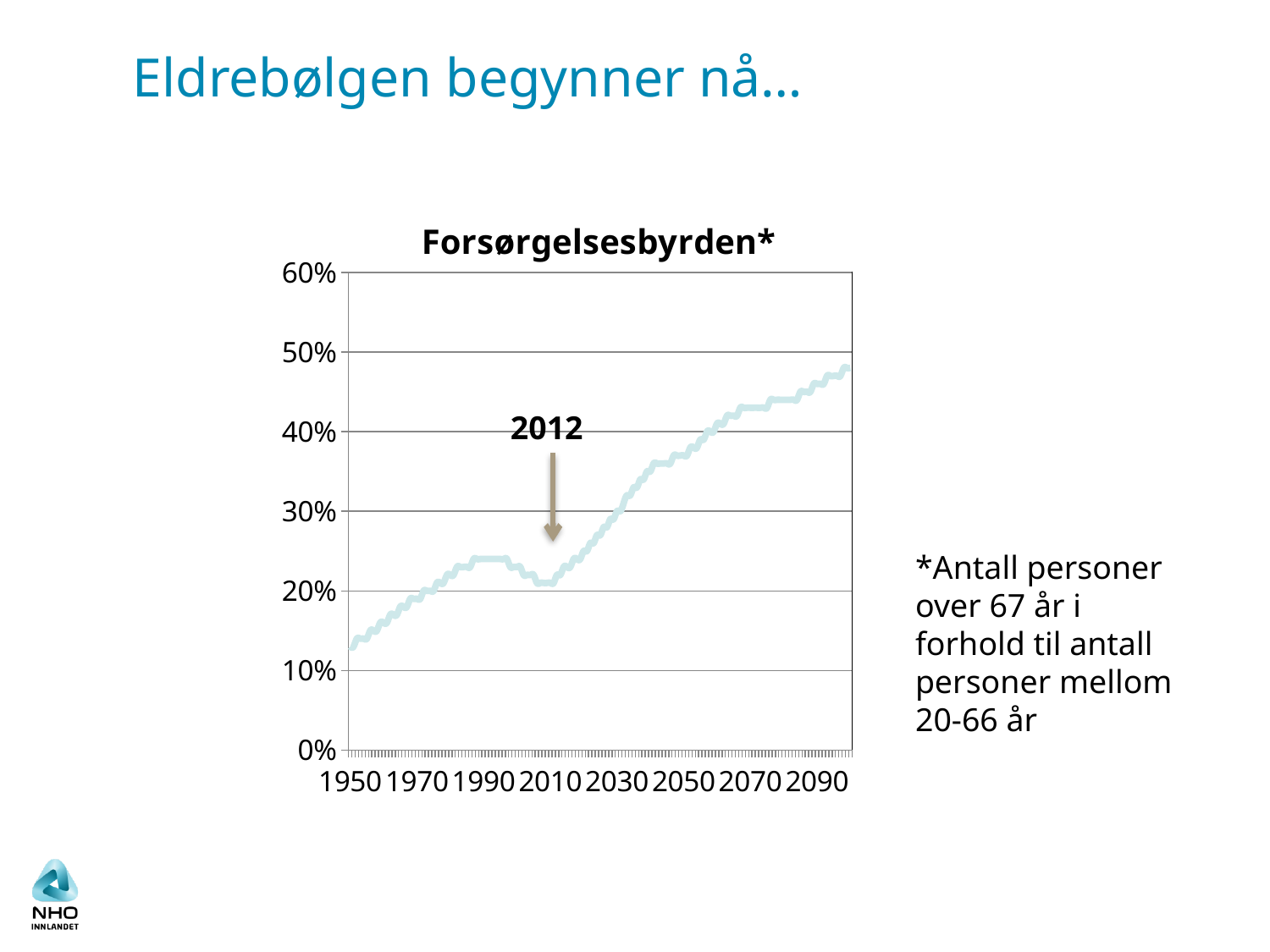
What is the title of the chart? Forsørgelsesbyrden* Which year is marked with an arrow annotation on the chart? 2012 Is the value for 2030 greater or less than 20%? greater Overall, does the value rise or fall from 1950 to 2090? rise Which of the labeled years on the x axis has the lowest value? 1950 Is the value for 2010 greater or less than 30%? less Is the value for 1950 greater or less than 20%? less Which of the labeled years on the x axis has the highest value? 2090 What kind of chart is shown on the slide? line chart Is the value for 2070 larger than the value for 1990? yes